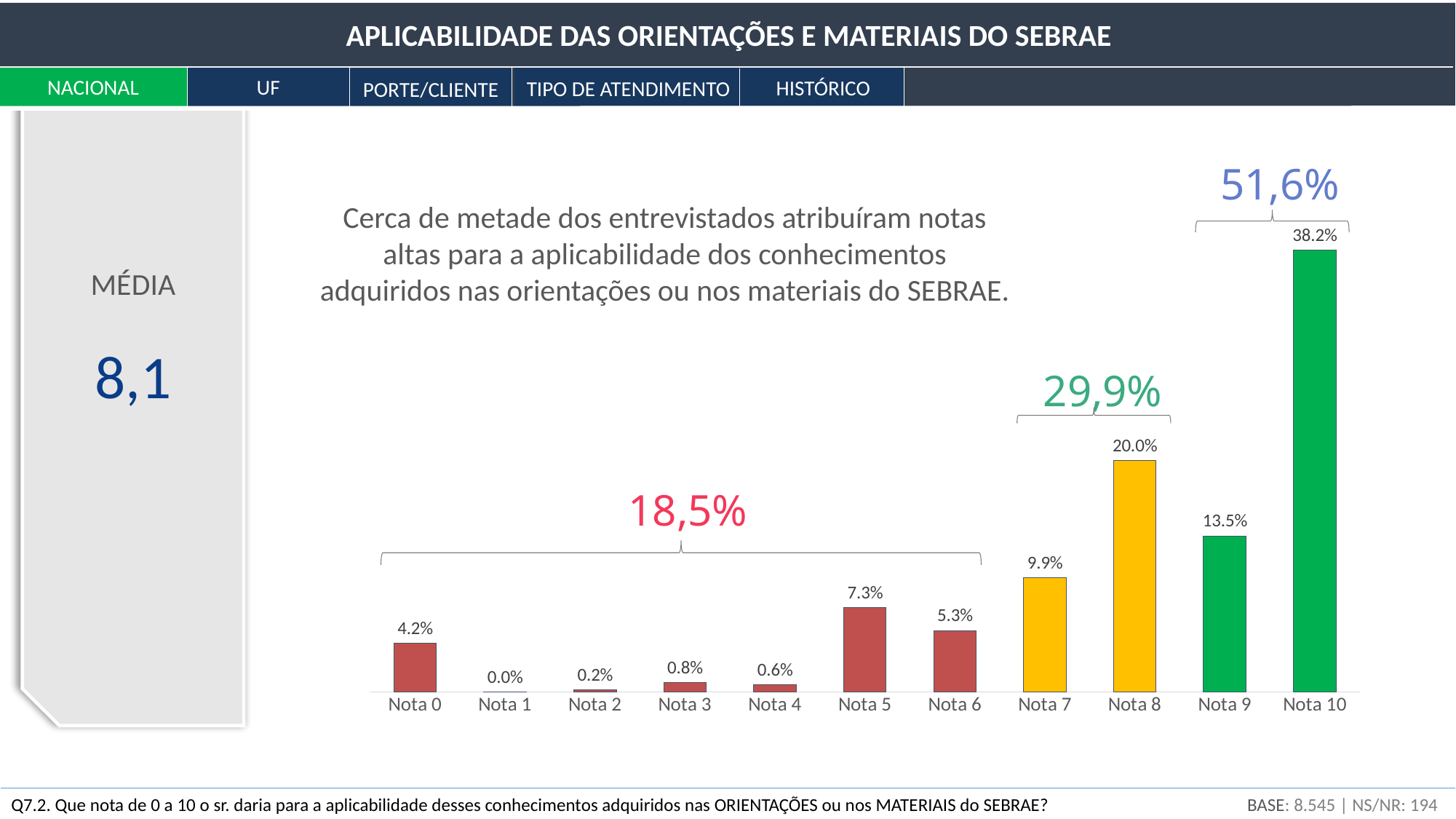
What kind of chart is shown on the slide? Bar chart How many categories are shown on the x axis? 11 What is the value shown under MÉDIA on the left of the slide? 8,1 What is the value for Nota 5? 7.3% What is the value for Nota 8? 20.0% What combined percentage is shown above the bracket covering Nota 9 and Nota 10? 51,6% What is the value for Nota 10? 38.2% What is the difference between the values for Nota 10 and Nota 8? 18.2% Which category has the lowest value? Nota 1 Which category has the highest value? Nota 10 What is the difference between the values for Nota 9 and Nota 7? 3.6% Which is larger, the value for Nota 5 or the value for Nota 6? Nota 5